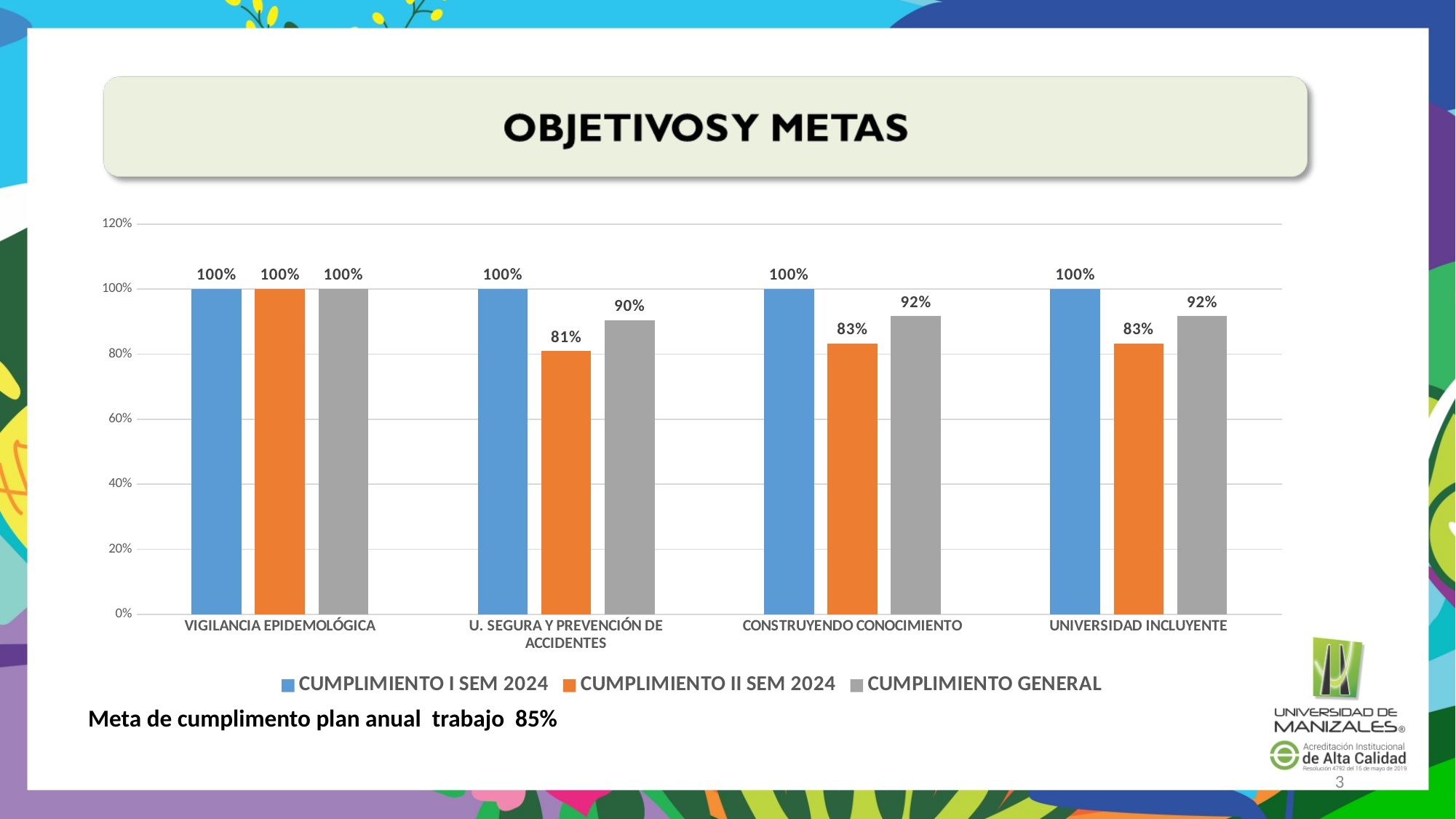
What is the CUMPLIMIENTO GENERAL value for VIGILANCIA EPIDEMOLÓGICA? 100% What is the CUMPLIMIENTO GENERAL value for CONSTRUYENDO CONOCIMIENTO? 92% How many series does the legend list? 3 Which category has the lowest CUMPLIMIENTO GENERAL value? U. SEGURA Y PREVENCIÓN DE ACCIDENTES Which category has the lowest CUMPLIMIENTO II SEM 2024 value? U. SEGURA Y PREVENCIÓN DE ACCIDENTES Which colour represents CUMPLIMIENTO II SEM 2024 in the legend? Orange What kind of chart is shown on the slide? Bar chart What is the difference between the CUMPLIMIENTO I SEM 2024 and CUMPLIMIENTO II SEM 2024 values for CONSTRUYENDO CONOCIMIENTO? 17% What is the CUMPLIMIENTO II SEM 2024 value for UNIVERSIDAD INCLUYENTE? 83% What is the CUMPLIMIENTO II SEM 2024 value for U. SEGURA Y PREVENCIÓN DE ACCIDENTES? 81% Which is larger for U. SEGURA Y PREVENCIÓN DE ACCIDENTES: CUMPLIMIENTO II SEM 2024 or CUMPLIMIENTO GENERAL? CUMPLIMIENTO GENERAL How many categories are shown on the x axis? 4